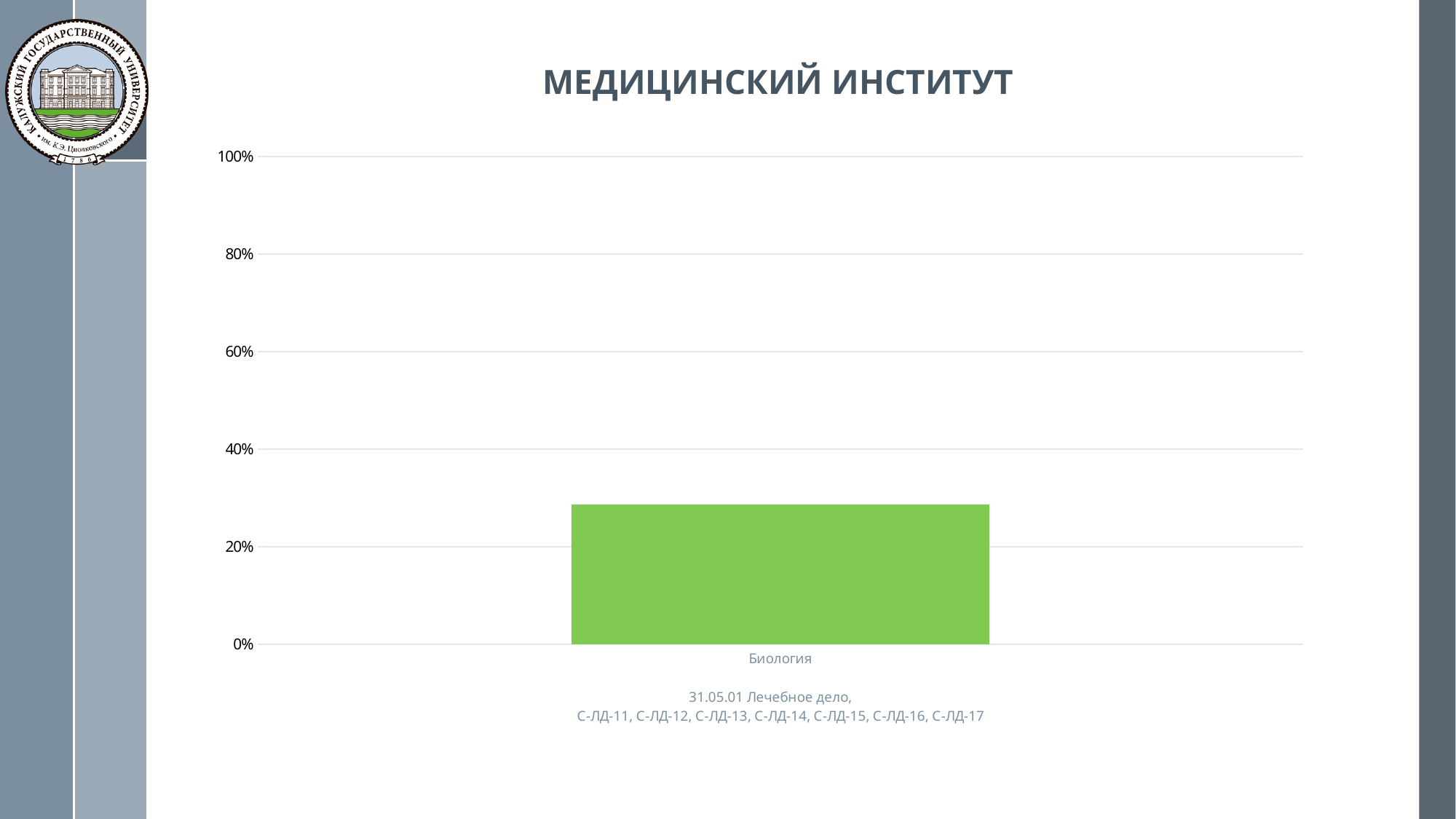
What kind of chart is shown on the slide? bar chart What is the title shown above the chart on the slide? МЕДИЦИНСКИЙ ИНСТИТУТ Is the value for Биология greater or less than 20%? greater Is the value for Биология greater or less than 40%? less Is the value for Биология greater or less than 60%? less What is the label of the category on the x axis of the chart? Биология What is the highest value shown on the y axis of the chart? 100% How many bars are plotted in the chart? 1